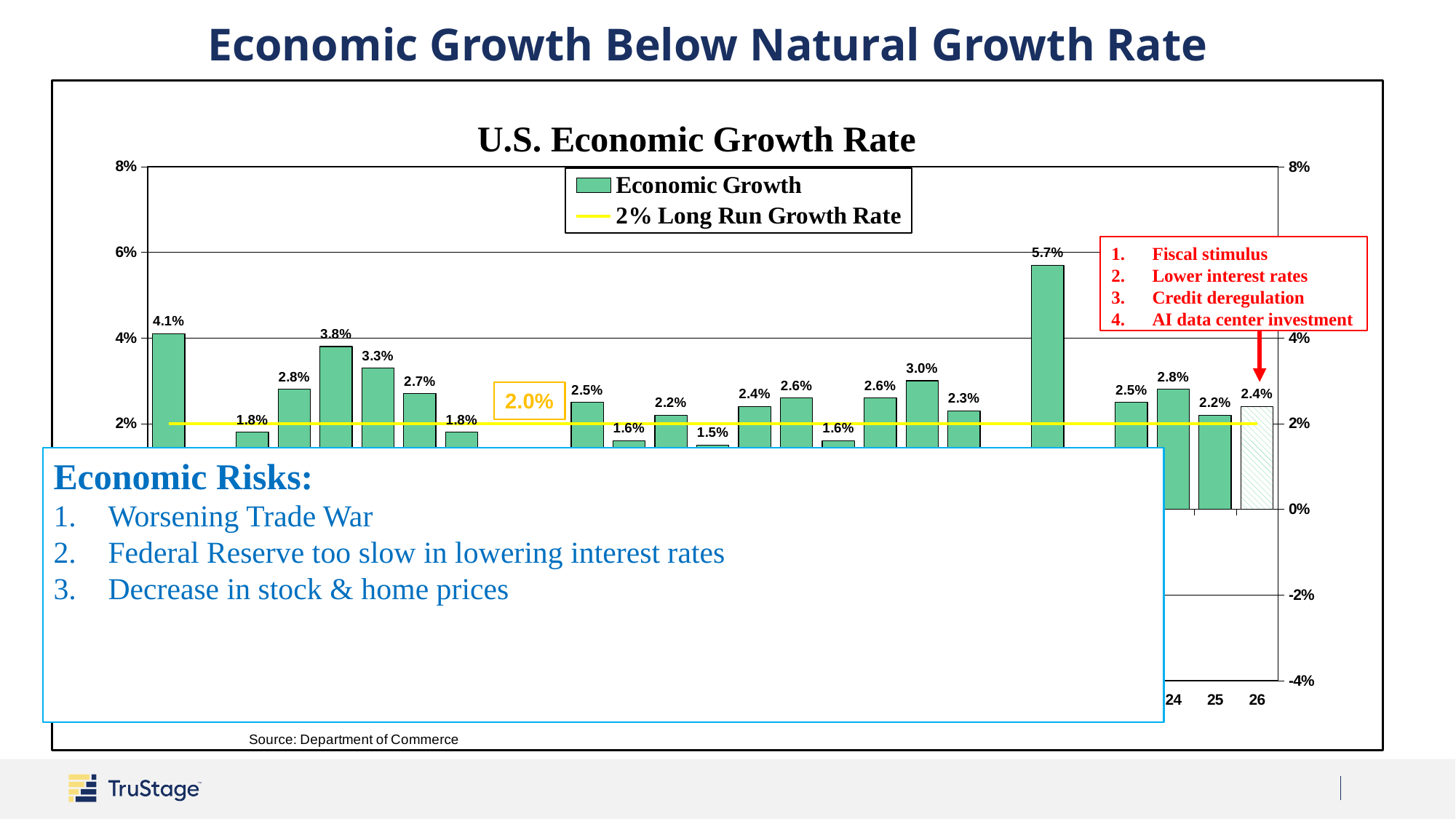
What is the difference between the Economic Growth values for 26 and 25? 0.2% What value is shown for the Long Run Growth Rate line? 2.0% Which has the larger Economic Growth value, 24 or 25? 24 What is the highest Economic Growth value labeled on the chart? 5.7% What is the Economic Growth value for 25? 2.2% What is the title of the chart? U.S. Economic Growth Rate What kind of chart is used to show Economic Growth? bar chart Is the Economic Growth value for 26 greater or less than 2%? greater What is the Economic Growth value for 24? 2.8% What is the Economic Growth value for 26? 2.4% How many series does the chart legend list? 2